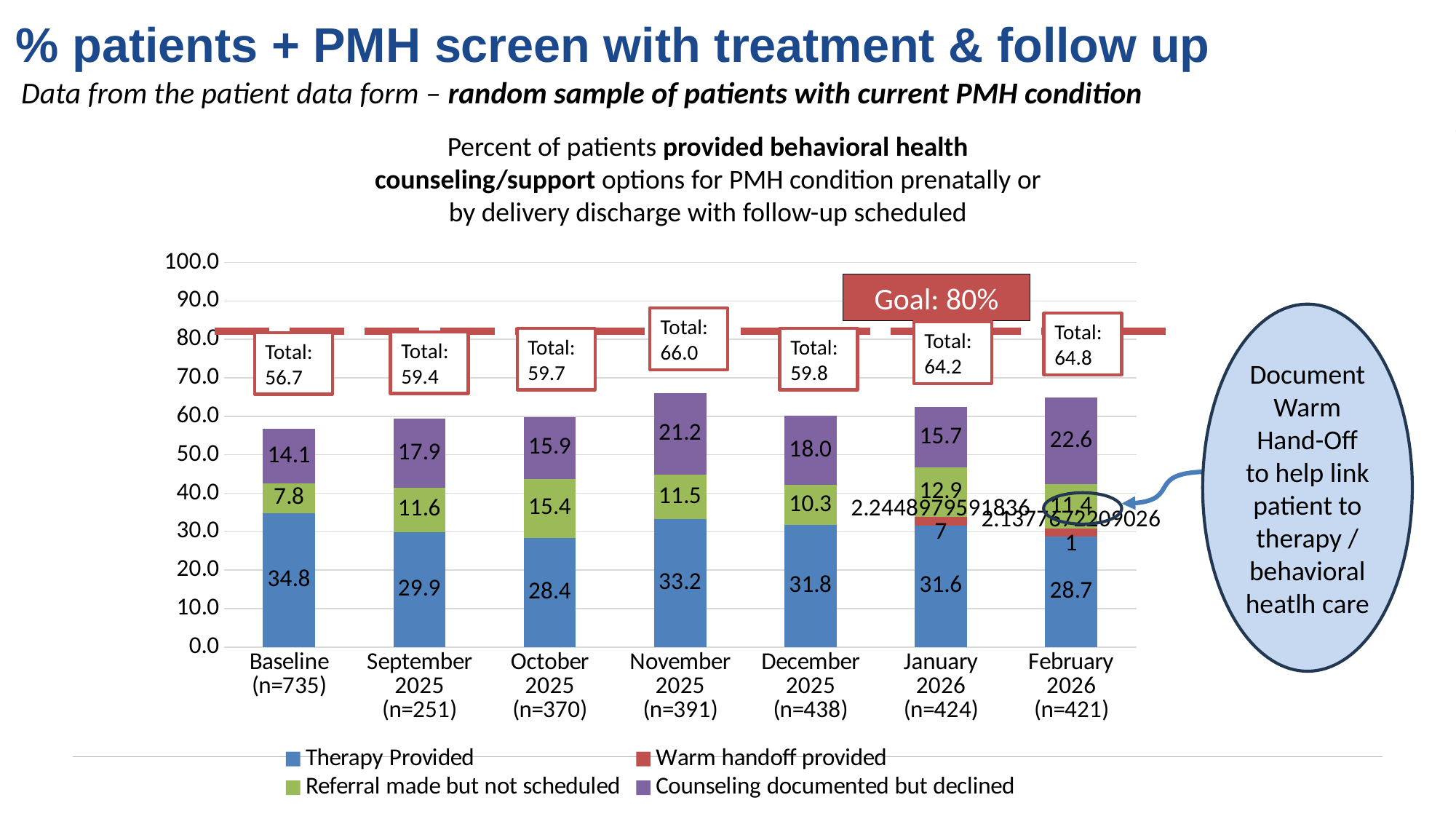
Which period has the highest total? November 2025 How many time-period categories are plotted along the x axis? 7 What is the difference between the Therapy Provided value for Baseline and for February 2026? 6.1 What is the Counseling documented but declined value for November 2025? 21.2 Which period has the lowest total? Baseline (n=735) What goal percentage is marked by the red line on the chart? 80% What is the total for February 2026? 64.8 How many series does the legend list? 4 What is the Therapy Provided value for Baseline (n=735)? 34.8 What is the Referral made but not scheduled value for December 2025? 10.3 Which is larger, the Referral made but not scheduled value for September 2025 or for October 2025? October 2025 What kind of chart is shown on the slide? Stacked bar chart